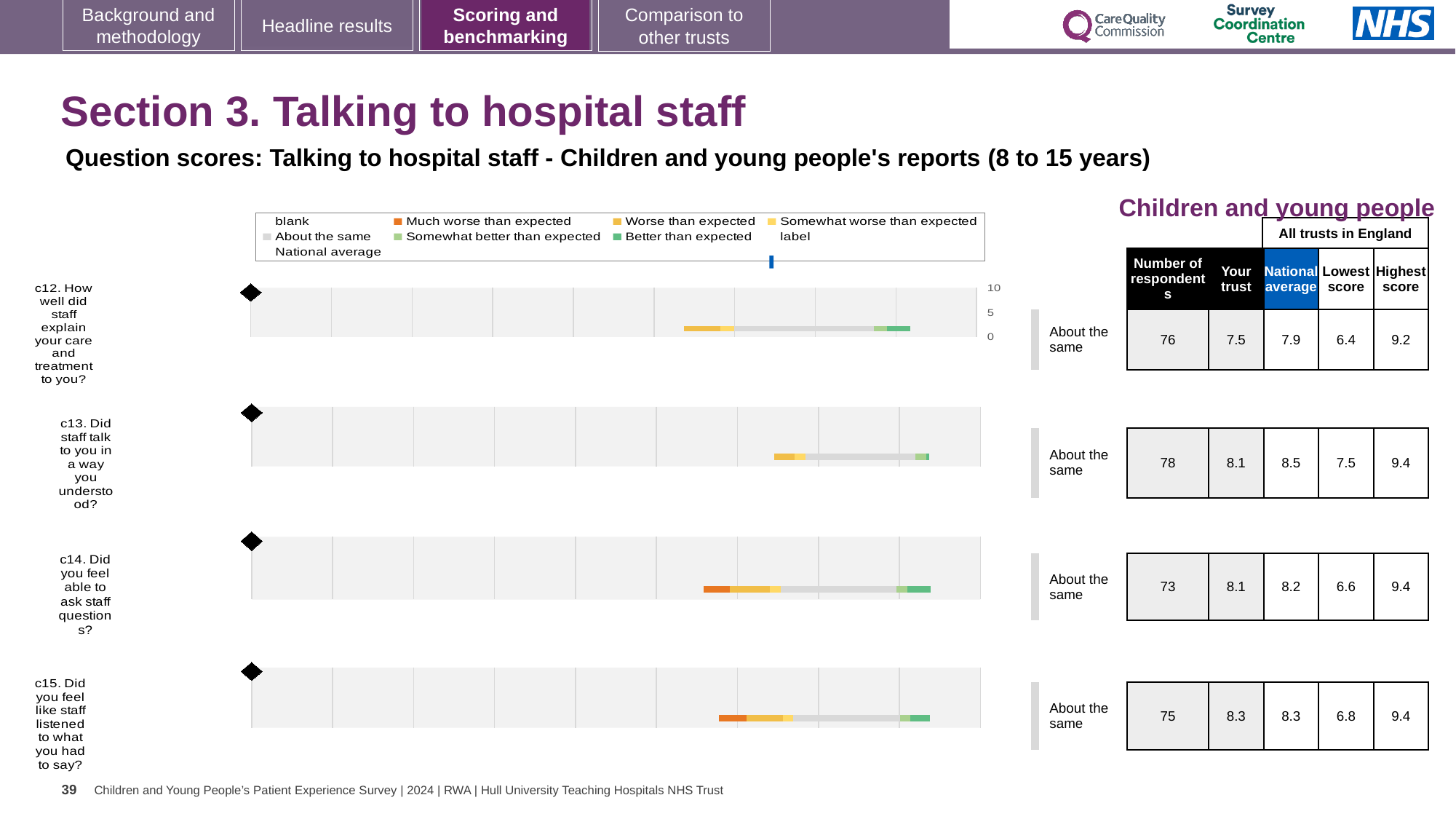
Which question has the highest 'Your trust' score? c15. Did you feel like staff listened to what you had to say? How many questions (c12 to c15) are plotted on the slide? 4 What is the highest score among all trusts in England for c15? 9.4 What is the national average score for c13 (Did staff talk to you in a way you understood?)? 8.5 For c13, what is the difference between the national average and the 'Your trust' score? 0.4 Which question has the lowest 'Your trust' score? c12. How well did staff explain your care and treatment to you? How many respondents answered c14 (Did you feel able to ask staff questions?)? 73 What benchmark category is shown next to the c14 chart? About the same For c12, which is larger: the 'Your trust' score or the national average? National average What is the 'Your trust' score for c12 (How well did staff explain your care and treatment to you?)? 7.5 What kind of chart is used to show the question scores for c12 to c15? bar chart What is the lowest score among all trusts in England for c12? 6.4